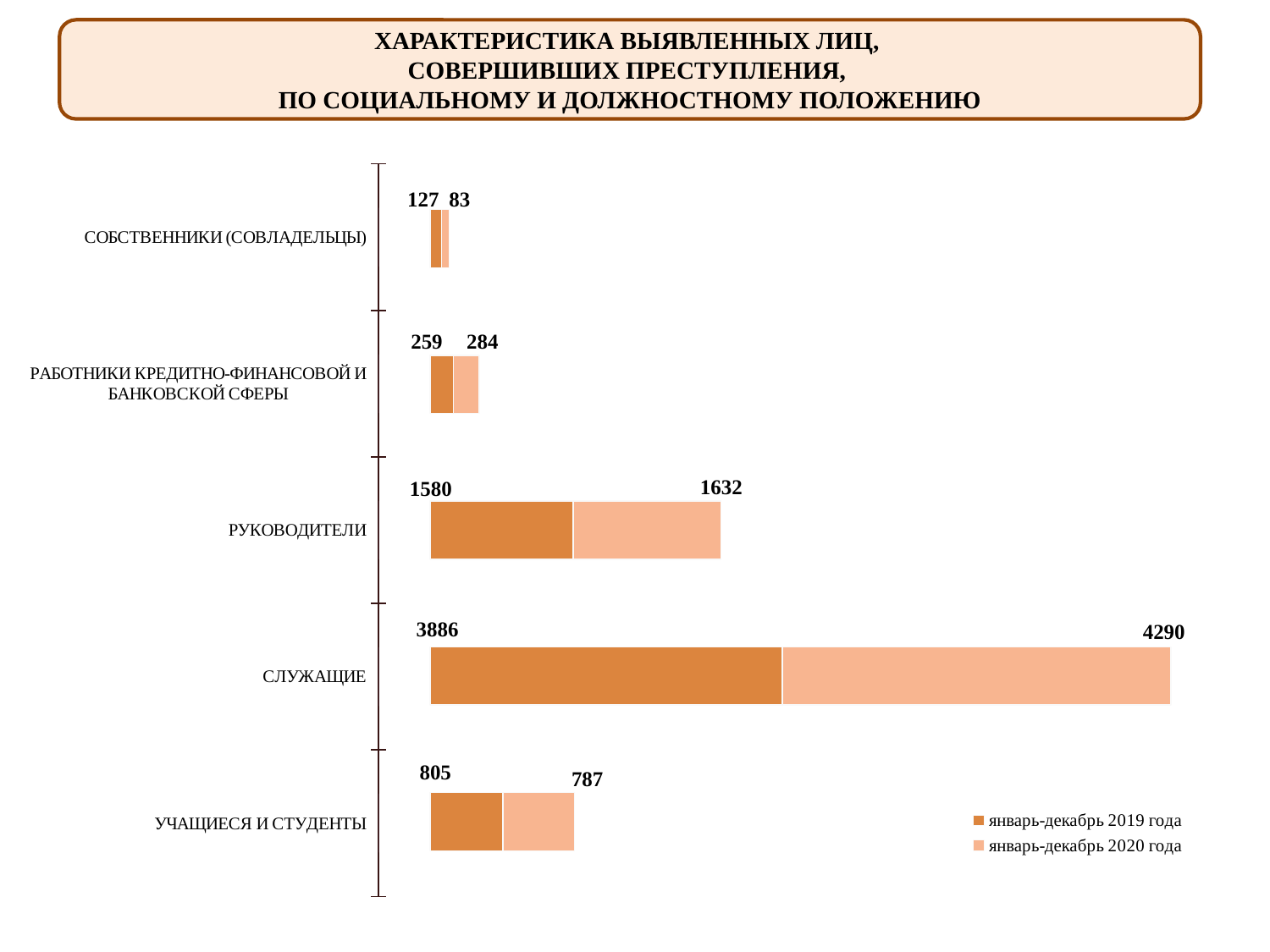
What is the difference between the январь-декабрь 2020 года and январь-декабрь 2019 года values for СЛУЖАЩИЕ? 404 What is the value for РУКОВОДИТЕЛИ in the январь-декабрь 2019 года series? 1580 For РАБОТНИКИ КРЕДИТНО-ФИНАНСОВОЙ И БАНКОВСКОЙ СФЕРЫ, which series has the larger value: январь-декабрь 2019 года or январь-декабрь 2020 года? январь-декабрь 2020 года What is the value for СОБСТВЕННИКИ (СОВЛАДЕЛЬЦЫ) in the январь-декабрь 2020 года series? 83 Which category has the highest value in the январь-декабрь 2019 года series? СЛУЖАЩИЕ What is the total of the stacked bar for РУКОВОДИТЕЛИ? 3212 How many series does the legend list? 2 How many categories are shown on the chart? 5 What kind of chart is shown on the slide? Stacked bar chart What is the value for УЧАЩИЕСЯ И СТУДЕНТЫ in the январь-декабрь 2019 года series? 805 What is the value for СЛУЖАЩИЕ in the январь-декабрь 2020 года series? 4290 Which category has the lowest value in the январь-декабрь 2020 года series? СОБСТВЕННИКИ (СОВЛАДЕЛЬЦЫ)